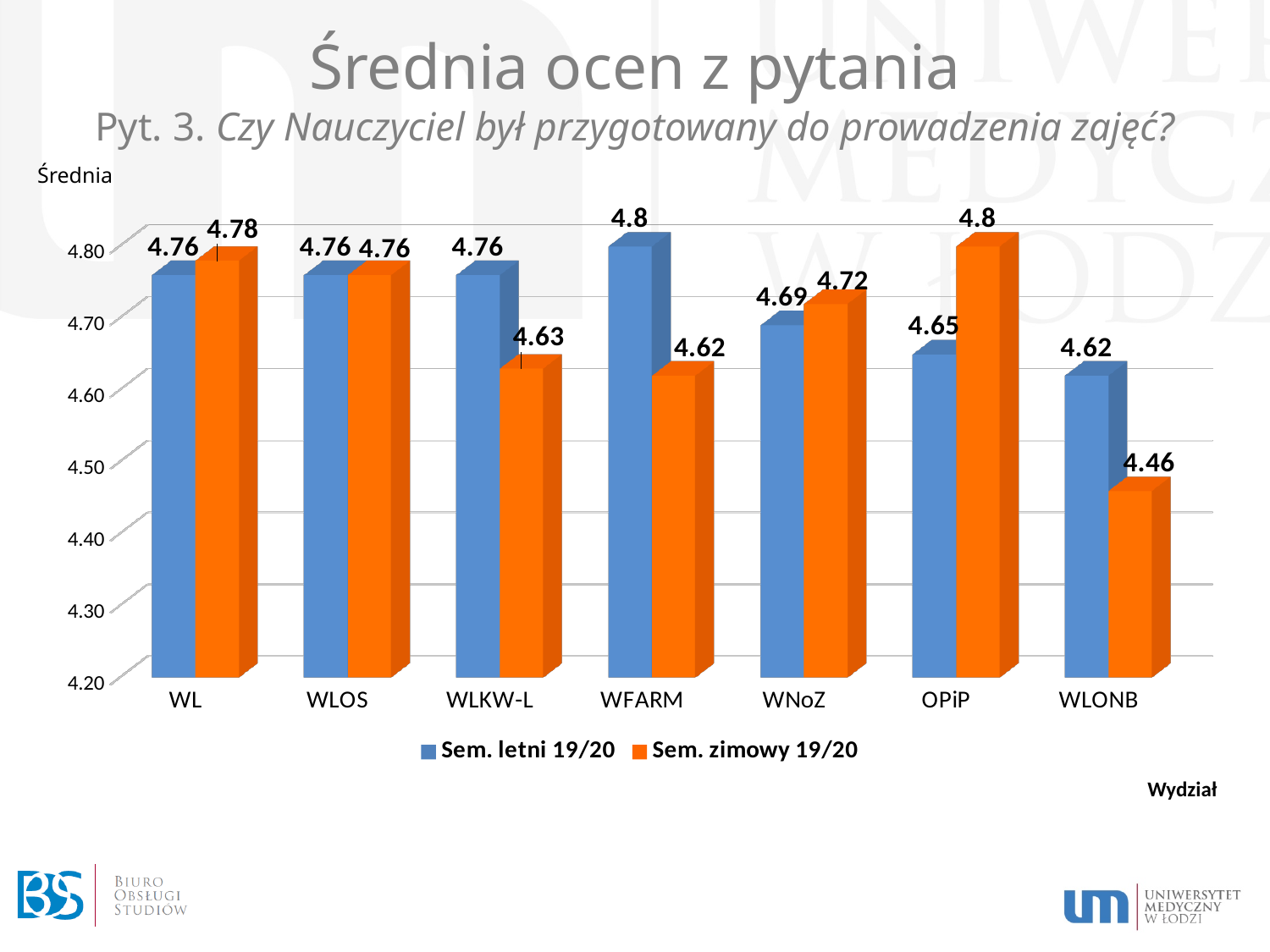
What kind of chart is shown on the slide? bar chart Which category has the lowest value in the Sem. zimowy 19/20 series? WLONB What is the value for WLONB in the Sem. zimowy 19/20 series? 4.46 Which is larger for OPiP: the Sem. letni 19/20 value or the Sem. zimowy 19/20 value? Sem. zimowy 19/20 How many series does the legend list? 2 What is the value for WNoZ in the Sem. zimowy 19/20 series? 4.72 What is the value for WFARM in the Sem. letni 19/20 series? 4.8 How many categories are shown on the x axis? 7 What is the difference between the Sem. letni 19/20 and Sem. zimowy 19/20 values for WLONB? 0.16 Which category has the highest value in the Sem. letni 19/20 series? WFARM What is the value for OPiP in the Sem. letni 19/20 series? 4.65 Which colour represents the Sem. zimowy 19/20 series? orange